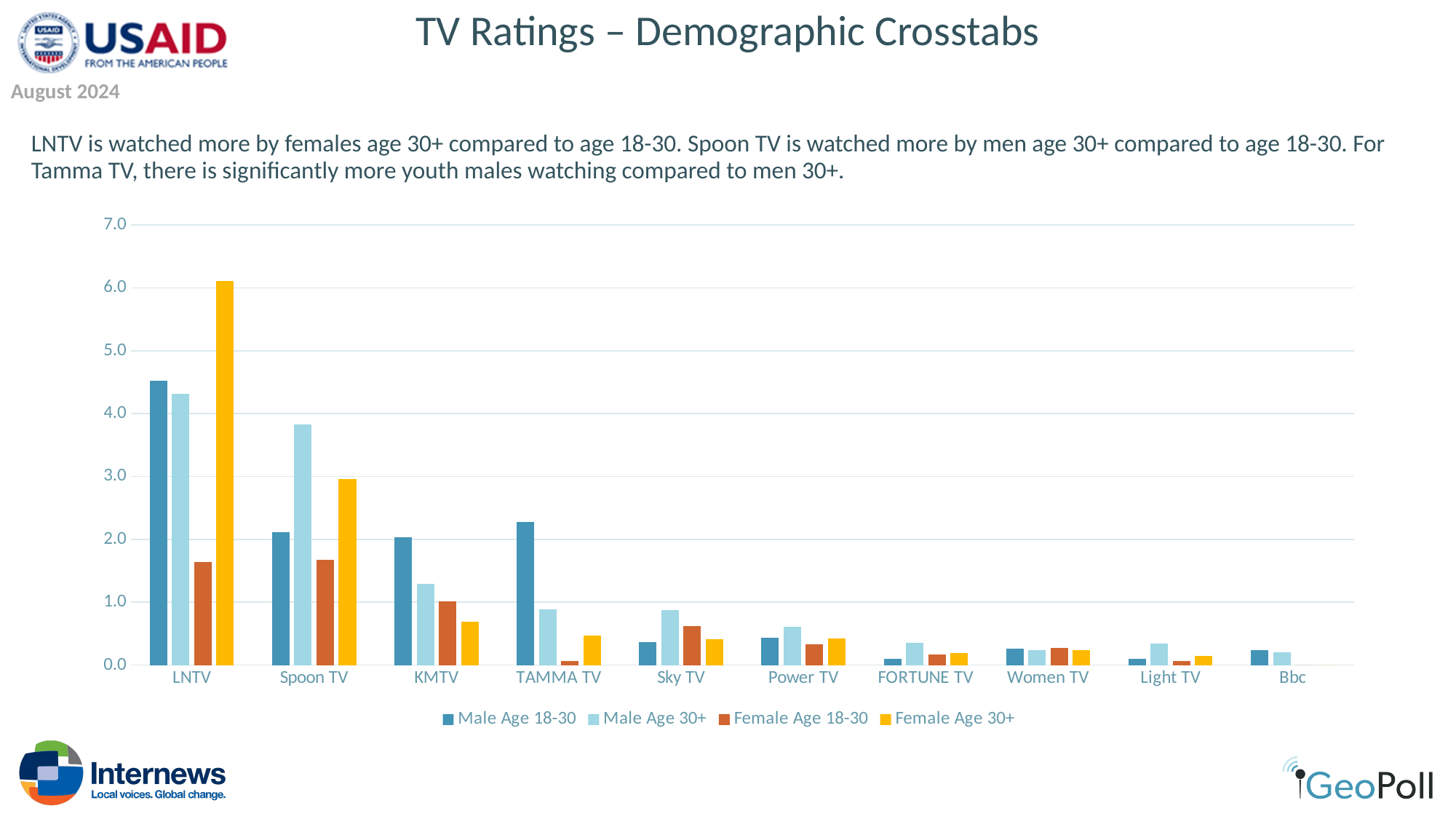
How many series does the chart's legend list? 4 What is the title of the slide containing the chart? TV Ratings – Demographic Crosstabs For Spoon TV, which is larger: the Male Age 30+ value or the Male Age 18-30 value? Male Age 30+ Is the Female Age 30+ value for LNTV greater or less than 6.0? greater Which series has the highest value for KMTV? Male Age 18-30 Which series has the lowest value for TAMMA TV? Female Age 18-30 Is the Male Age 30+ value for Spoon TV greater or less than 3.0? greater Which TV channel has the highest Female Age 30+ value? LNTV For TAMMA TV, which is larger: the Male Age 18-30 value or the Male Age 30+ value? Male Age 18-30 What kind of chart is shown on the slide? Bar chart Is the Male Age 18-30 value for LNTV greater or less than 4.0? greater How many TV channels are shown on the x axis of the chart? 10